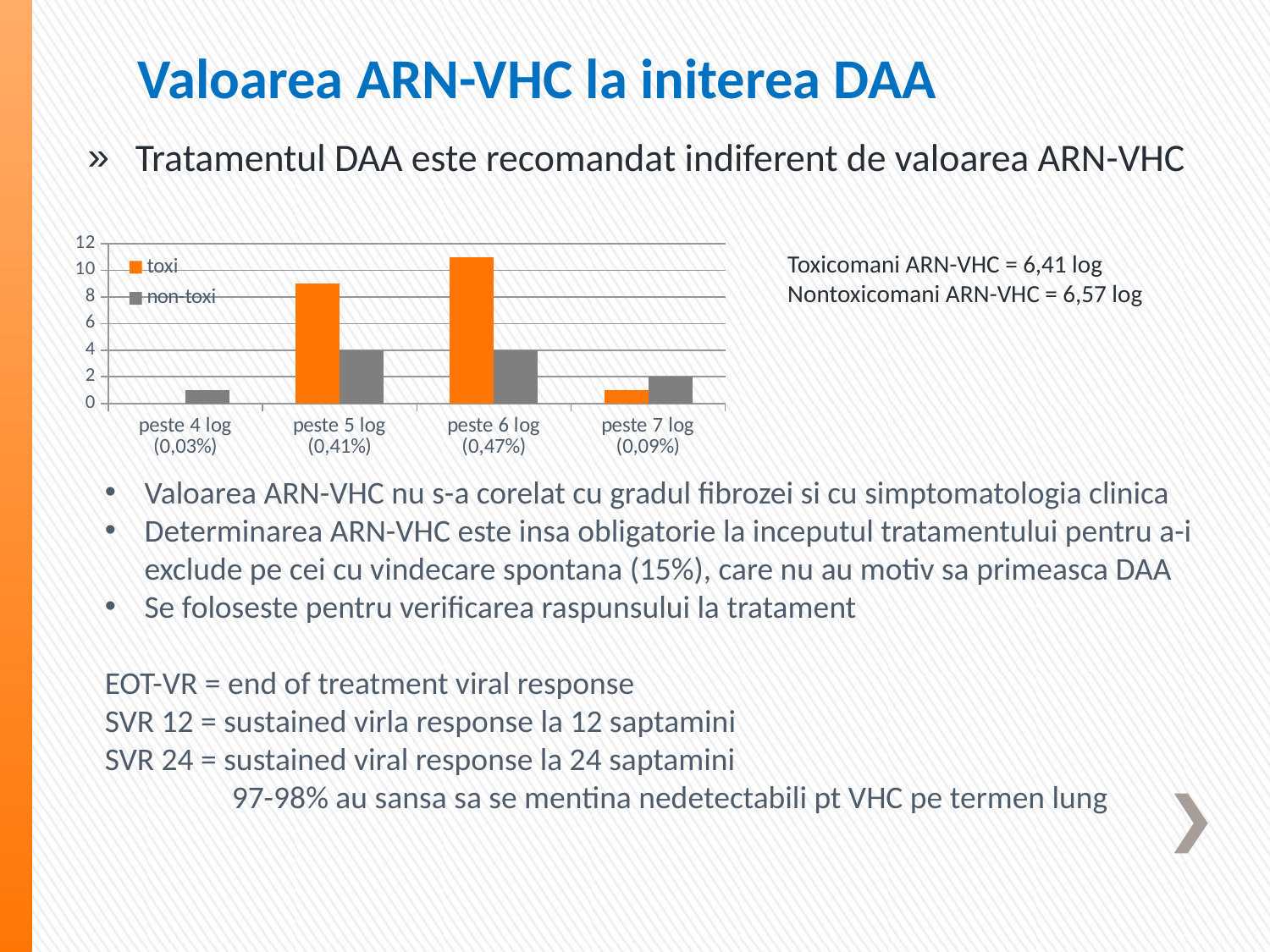
What is the value of the non-toxi bar for peste 7 log (0,09%)? 2 What are the two series named in the chart legend? toxi and non-toxi Is the value of the toxi bar for peste 6 log (0,47%) greater or less than 10? greater For which category is the toxi bar highest? peste 6 log (0,47%) Is the value of the toxi bar for peste 5 log (0,41%) greater or less than 8? greater For peste 7 log (0,09%), which series has the larger bar, toxi or non-toxi? non-toxi How many categories are shown on the x axis of the chart? 4 What colour are the bars for the toxi series? orange What is the value of the non-toxi bar for peste 5 log (0,41%)? 4 For which category is the non-toxi bar lowest? peste 4 log (0,03%) What kind of chart is shown on the slide? bar chart How many series does the chart legend list? 2